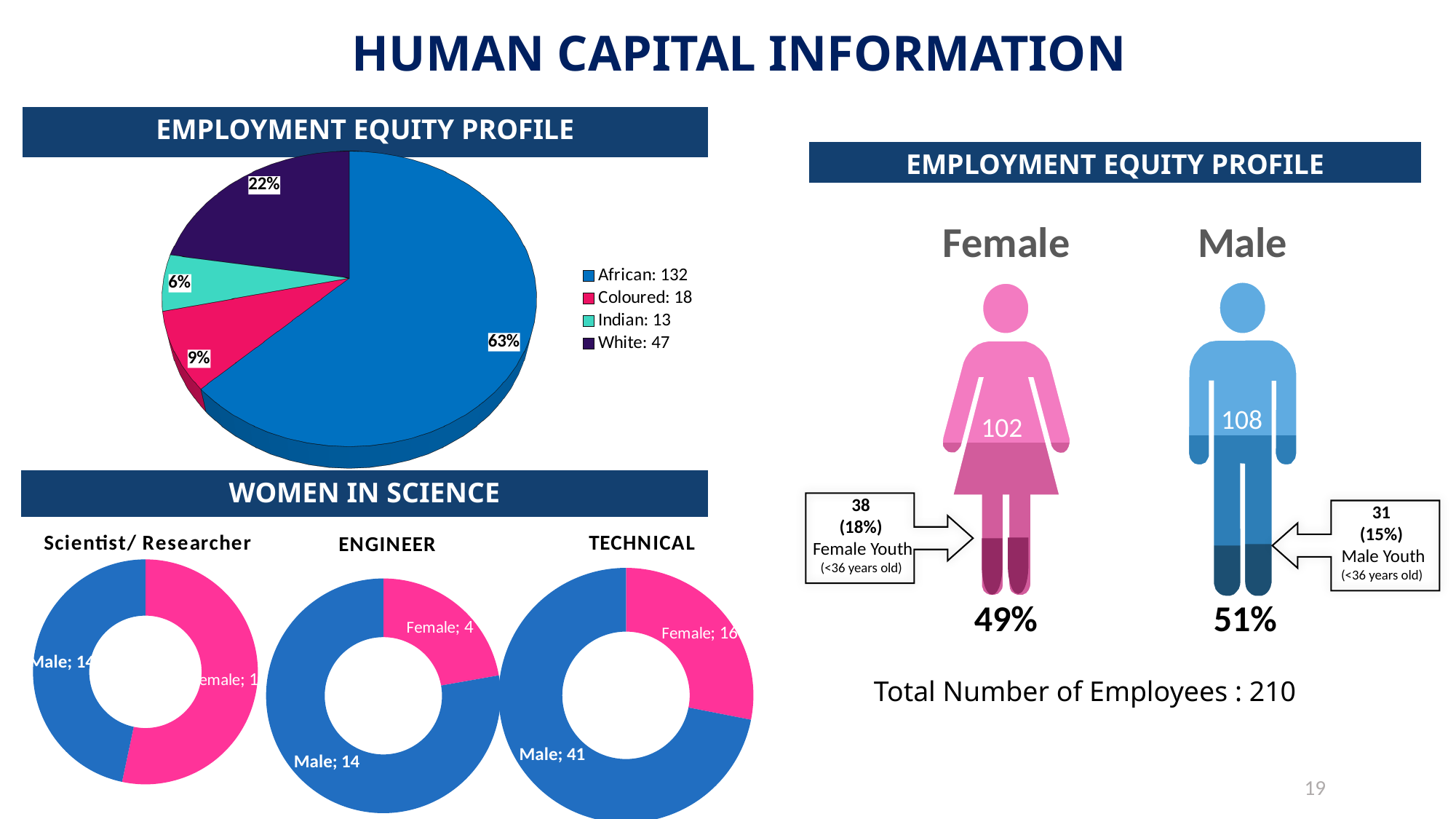
In the Employment Equity Profile pie chart, which category has the largest slice? African In the Employment Equity Profile pie chart, what is the difference between the White and Coloured counts? 29 In the Employment Equity Profile pie chart, what percentage share does the Coloured slice have? 9% What kind of chart is used for the Employment Equity Profile on the left of the slide? Pie chart In the Employment Equity Profile pie chart, which category has the smallest slice? Indian In the Women in Science Engineer donut chart, how many females are there? 4 In the Women in Science Engineer donut chart, which is larger, Male or Female? Male In the Employment Equity Profile pie chart, what percentage share does the White slice have? 22% In the Women in Science Technical donut chart, what is the difference between the male and female counts? 25 In the Employment Equity Profile pie chart, how many employees are African? 132 In the Women in Science Technical donut chart, how many males are there? 41 How many categories does the Employment Equity Profile pie chart show? 4